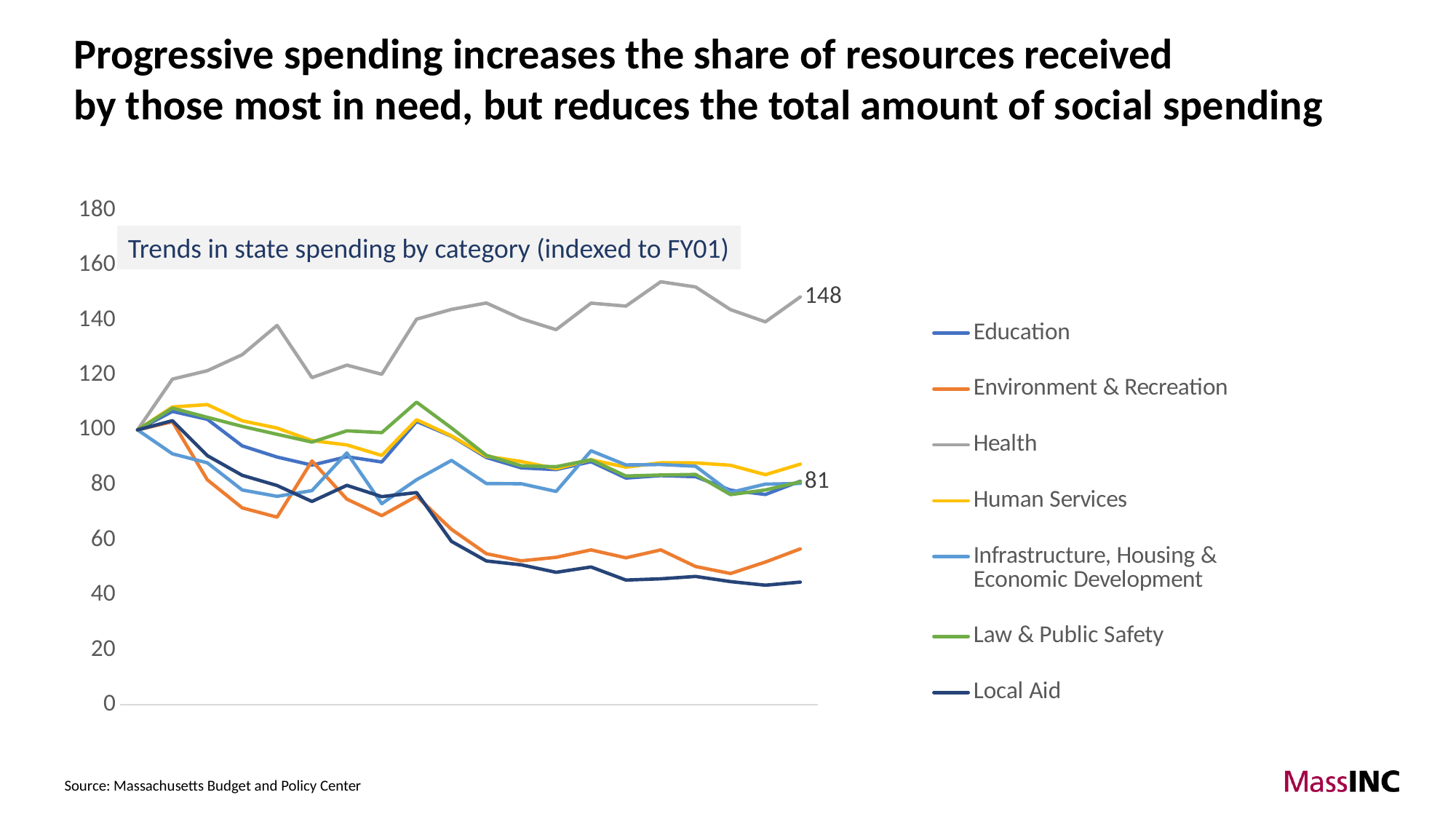
Is the final value for Health greater or less than 140? greater What is the title of the chart? Trends in state spending by category (indexed to FY01) What kind of chart is shown on the slide? line chart Is the final value for Environment & Recreation greater or less than 80? less Is the final value for Local Aid greater or less than 60? less What value is labeled at the end of the Health line? 148 Which series has the highest value at the right end of the chart? Health Does the Health line generally rise or fall from left to right? rise How many series does the legend list? 7 At the right end of the chart, which is larger: Health or Local Aid? Health Does the Local Aid line generally rise or fall from left to right? fall Which series has the lowest value at the right end of the chart? Local Aid